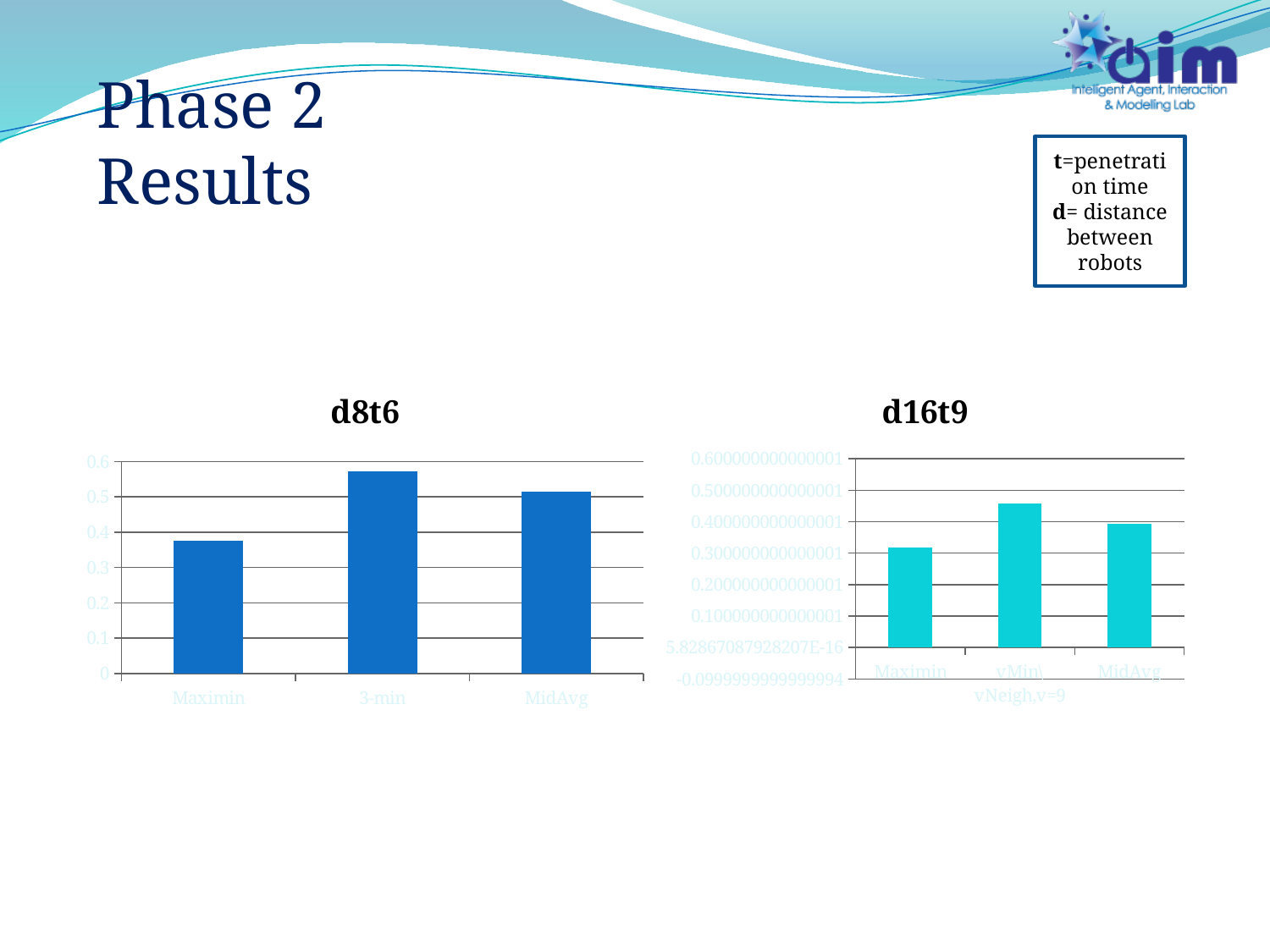
In the d8t6 chart, which is larger, the value for MidAvg or the value for Maximin? MidAvg In the d8t6 chart, which category has the highest value? 3-min In the d8t6 chart, is the value for 3-min greater or less than 0.5? greater What kind of chart is the d16t9 chart? bar chart What is the title of the chart on the right side of the slide? d16t9 How many categories are shown in the d8t6 chart? 3 In the d16t9 chart, which category has the lowest value? Maximin In the d16t9 chart, is the value for Maximin greater or less than 0.4? less In the d8t6 chart, which category has the lowest value? Maximin What kind of chart is the d8t6 chart? bar chart In the d8t6 chart, is the value for Maximin greater or less than 0.4? less How many bars are shown in the d16t9 chart? 3